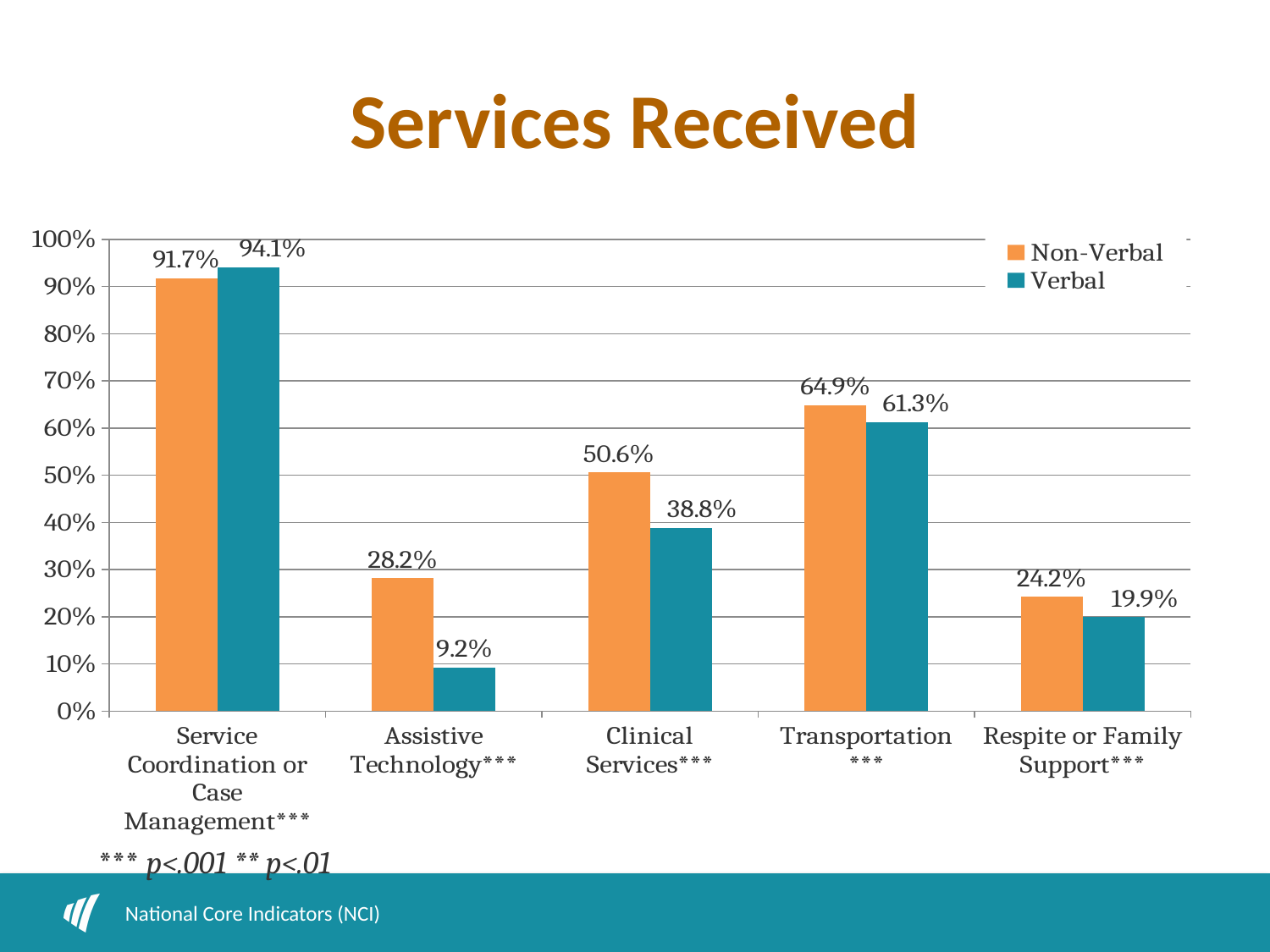
What is the difference between the Non-Verbal and Verbal values for Transportation? 3.6% What is the Non-Verbal value for Assistive Technology? 28.2% Which category has the highest Non-Verbal value? Service Coordination or Case Management How many series does the legend list? 2 What is the title of the chart? Services Received What kind of chart is shown on the slide? Bar chart What is the difference between the Non-Verbal and Verbal values for Assistive Technology? 19.0% What is the Verbal value for Service Coordination or Case Management? 94.1% Which category has the lowest Verbal value? Assistive Technology For Clinical Services, which series has the larger value, Non-Verbal or Verbal? Non-Verbal What is the Verbal value for Clinical Services? 38.8% How many categories are shown on the x axis? 5